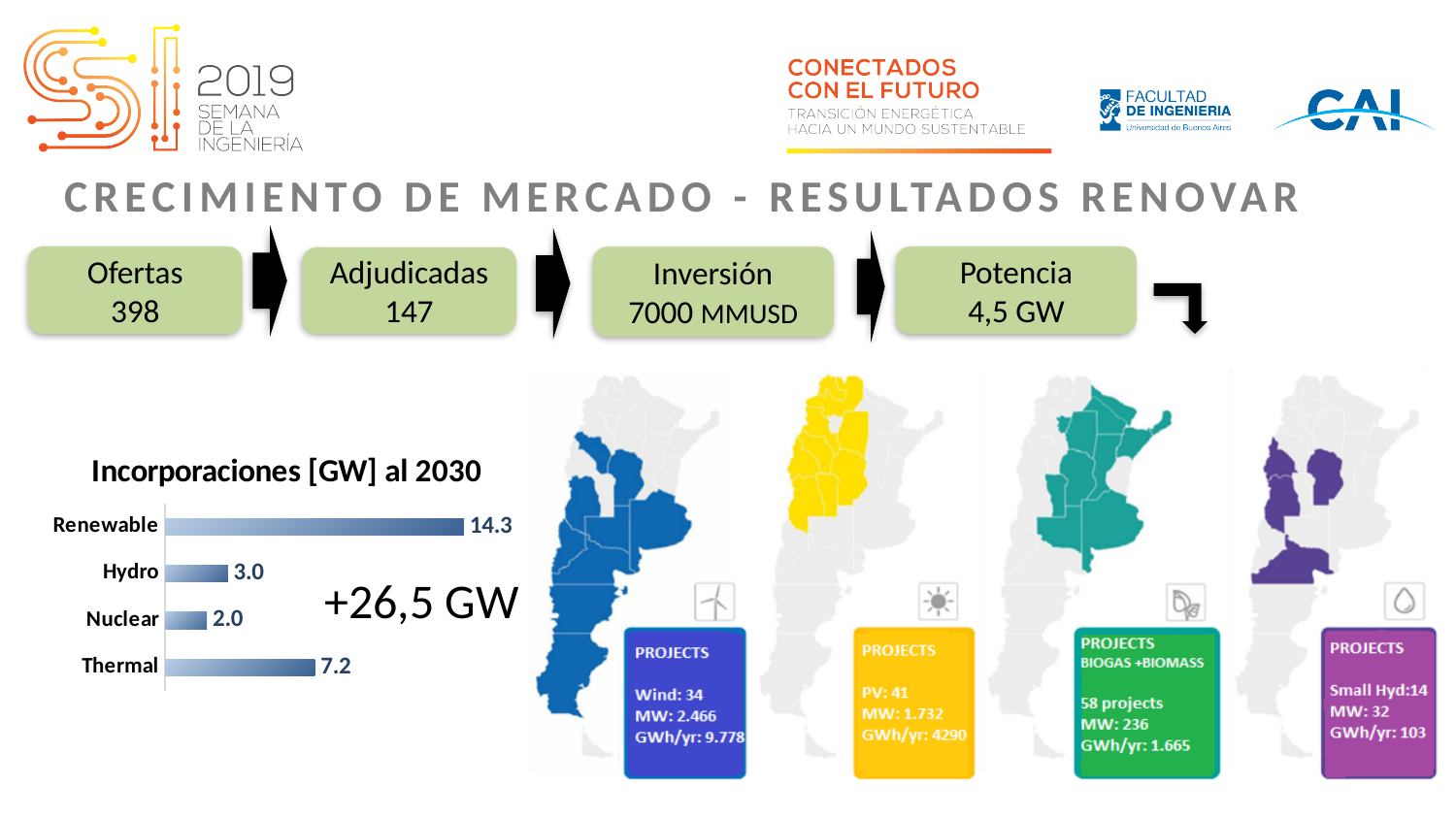
What is the title of the bar chart on the slide? Incorporaciones [GW] al 2030 What kind of chart is 'Incorporaciones [GW] al 2030'? Bar chart What is the value for Hydro in the 'Incorporaciones [GW] al 2030' chart? 3.0 What is the value for Nuclear in the 'Incorporaciones [GW] al 2030' chart? 2.0 Which category has the highest value in the 'Incorporaciones [GW] al 2030' chart? Renewable In the 'Incorporaciones [GW] al 2030' chart, which is larger, Thermal or Hydro? Thermal What is the difference between the Renewable and Thermal values in the 'Incorporaciones [GW] al 2030' chart? 7.1 What is the value for Renewable in the 'Incorporaciones [GW] al 2030' chart? 14.3 Which category has the lowest value in the 'Incorporaciones [GW] al 2030' chart? Nuclear What is the value for Thermal in the 'Incorporaciones [GW] al 2030' chart? 7.2 How many categories are shown in the 'Incorporaciones [GW] al 2030' chart? 4 What is the difference between the Hydro and Nuclear values in the 'Incorporaciones [GW] al 2030' chart? 1.0